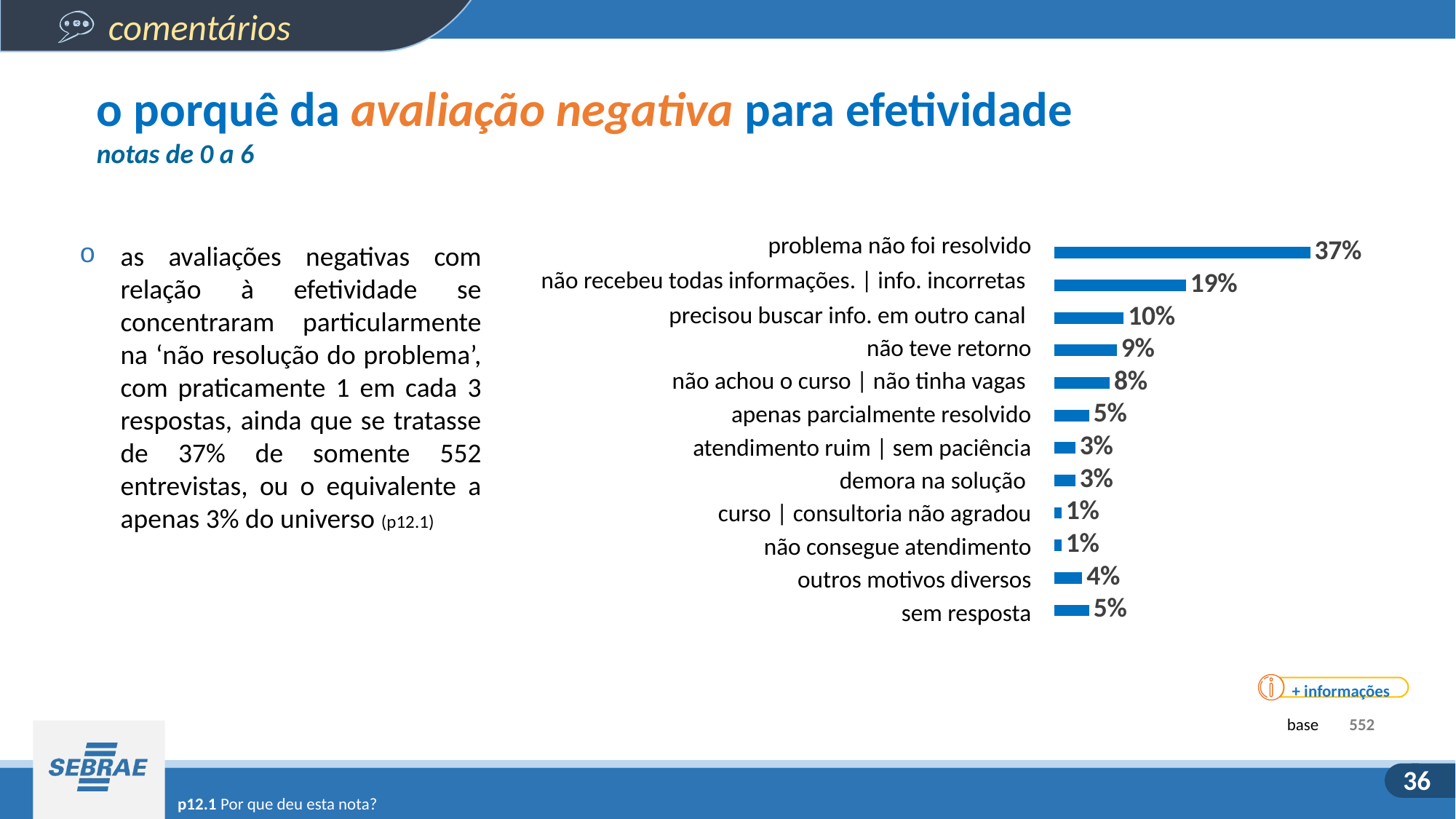
What is the value for 'não recebeu todas informações. | info. incorretas'? 19% What is the value for 'outros motivos diversos'? 4% What is the value for 'problema não foi resolvido'? 37% What is the base (number of interviews) shown for the chart? 552 How many categories are shown in the chart? 12 What kind of chart is shown on the slide? bar chart Which category has the highest value? problema não foi resolvido What is the difference between 'problema não foi resolvido' and 'não recebeu todas informações. | info. incorretas'? 18% What is the value for 'não teve retorno'? 9% Which is larger, 'sem resposta' or 'outros motivos diversos'? sem resposta What is the difference between 'precisou buscar info. em outro canal' and 'não achou o curso | não tinha vagas'? 2% Which is larger, 'não teve retorno' or 'apenas parcialmente resolvido'? não teve retorno